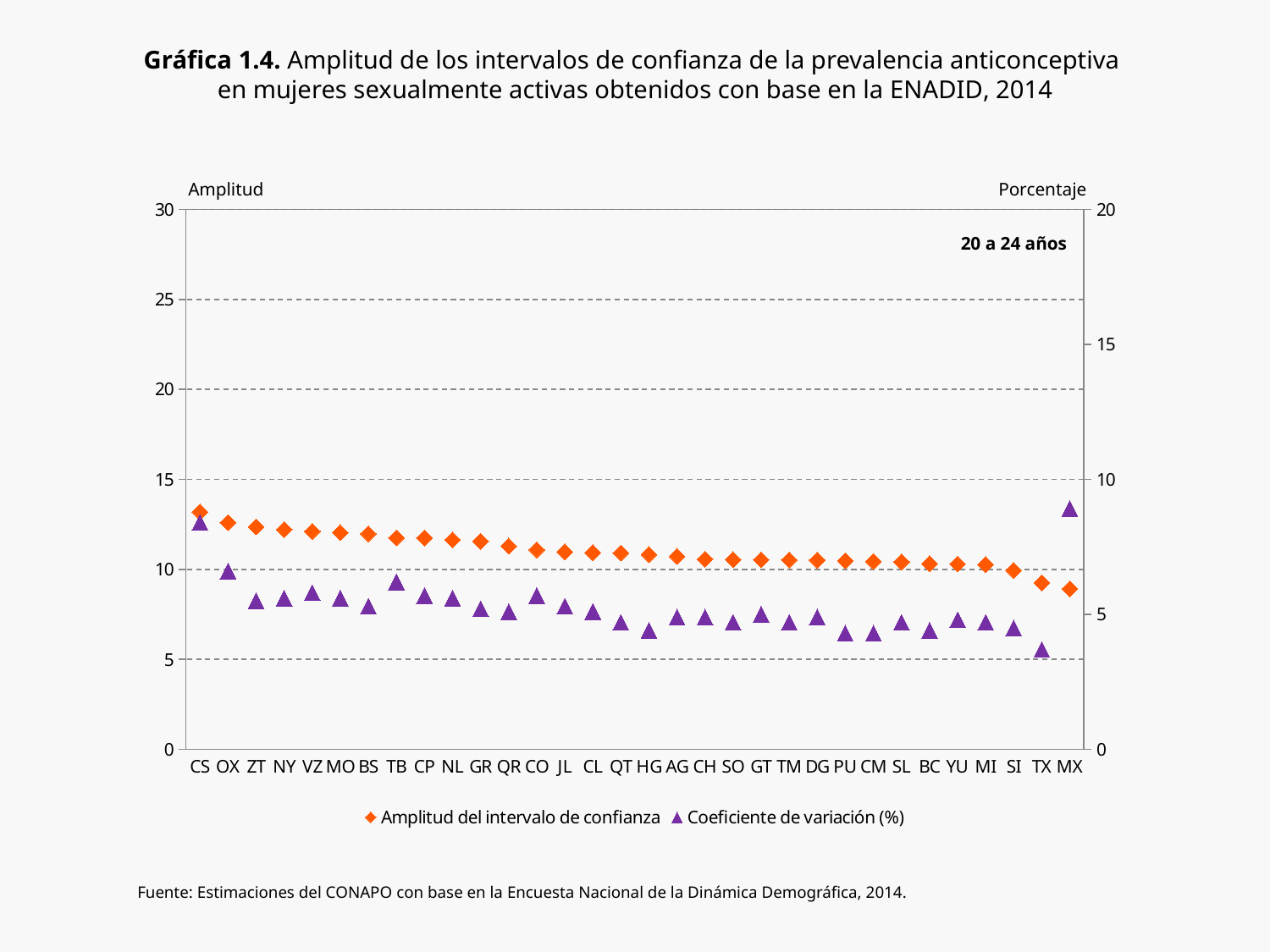
Is the Coeficiente de variación (%) value for TX greater or less than 5? less How many categories (states) are plotted along the x axis? 32 Which age group is indicated in the label inside the plot area? 20 a 24 años Is the Amplitud del intervalo de confianza value for MX greater or less than 10? less Which state has the highest value for Amplitud del intervalo de confianza? CS Which state has the lowest value for Coeficiente de variación (%)? TX Which state has the lowest value for Amplitud del intervalo de confianza? MX Which is larger, the Amplitud del intervalo de confianza for CS or for MX? CS What kind of chart is shown on the slide? scatter chart How many series does the legend list? 2 Do the values for Amplitud del intervalo de confianza rise or fall from left to right along the x axis? fall Is the Amplitud del intervalo de confianza value for CS greater or less than 10? greater